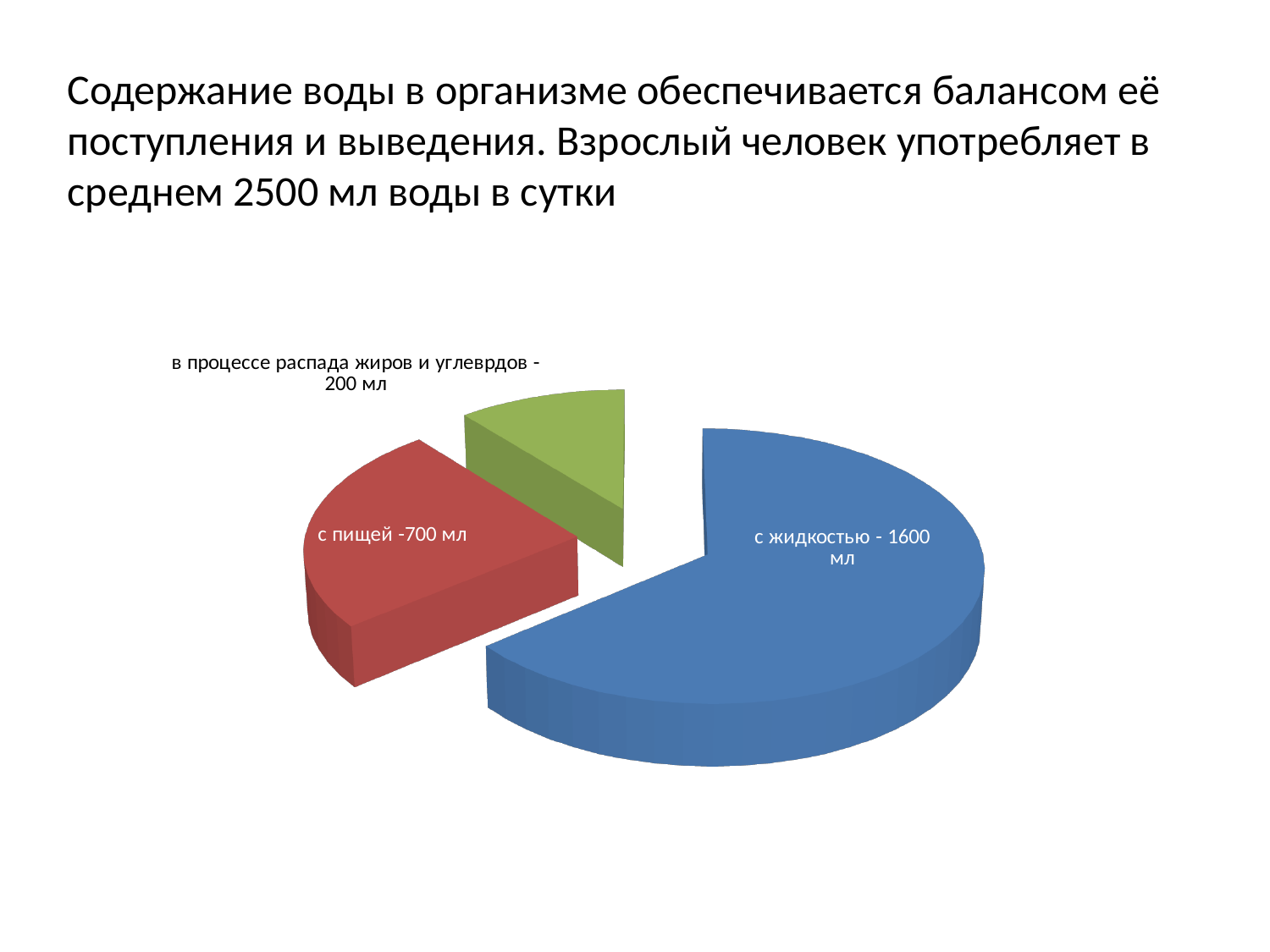
Which slice of the pie chart is the largest? с жидкостью - 1600 мл What kind of chart is shown on the slide? pie chart What share of the pie does the slice "с жидкостью" represent? 64% Which slice of the pie chart is the smallest? в процессе распада жиров и углеврдов - 200 мл What is the difference between the value for "с жидкостью" and the value for "с пищей"? 900 мл What value is shown for the slice "в процессе распада жиров и углеврдов"? 200 мл What colour is the slice for "с пищей"? red Which is larger: the value for "с пищей" or the value for "в процессе распада жиров и углеврдов"? с пищей What value is shown for the slice "с жидкостью"? 1600 мл What value is shown for the slice "с пищей"? 700 мл What is the total of all three slices in the pie chart? 2500 мл How many slices does the pie chart have? 3